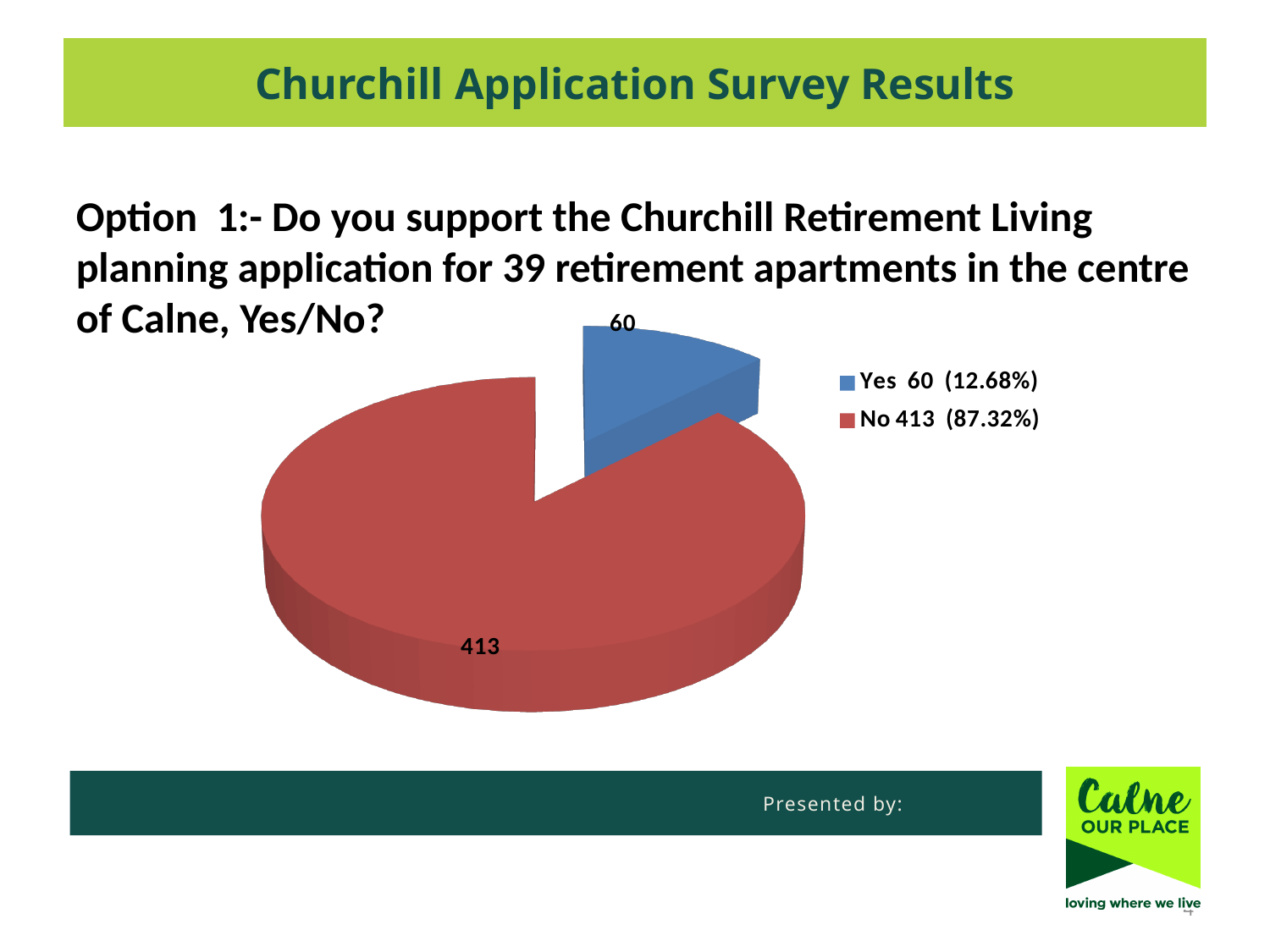
What colour is the No slice of the pie chart? red What share of the pie does the Yes slice represent? 12.68% Which is larger, the number of Yes responses or the number of No responses? No How many entries does the legend list? 2 What kind of chart is shown on the slide? pie chart How many responses are shown for No? 413 What share of the pie does the No slice represent? 87.32% What is the difference between the number of No and Yes responses? 353 Which response received the fewest votes? Yes Which response received the most votes? No How many slices does the pie chart have? 2 How many responses are shown for Yes? 60